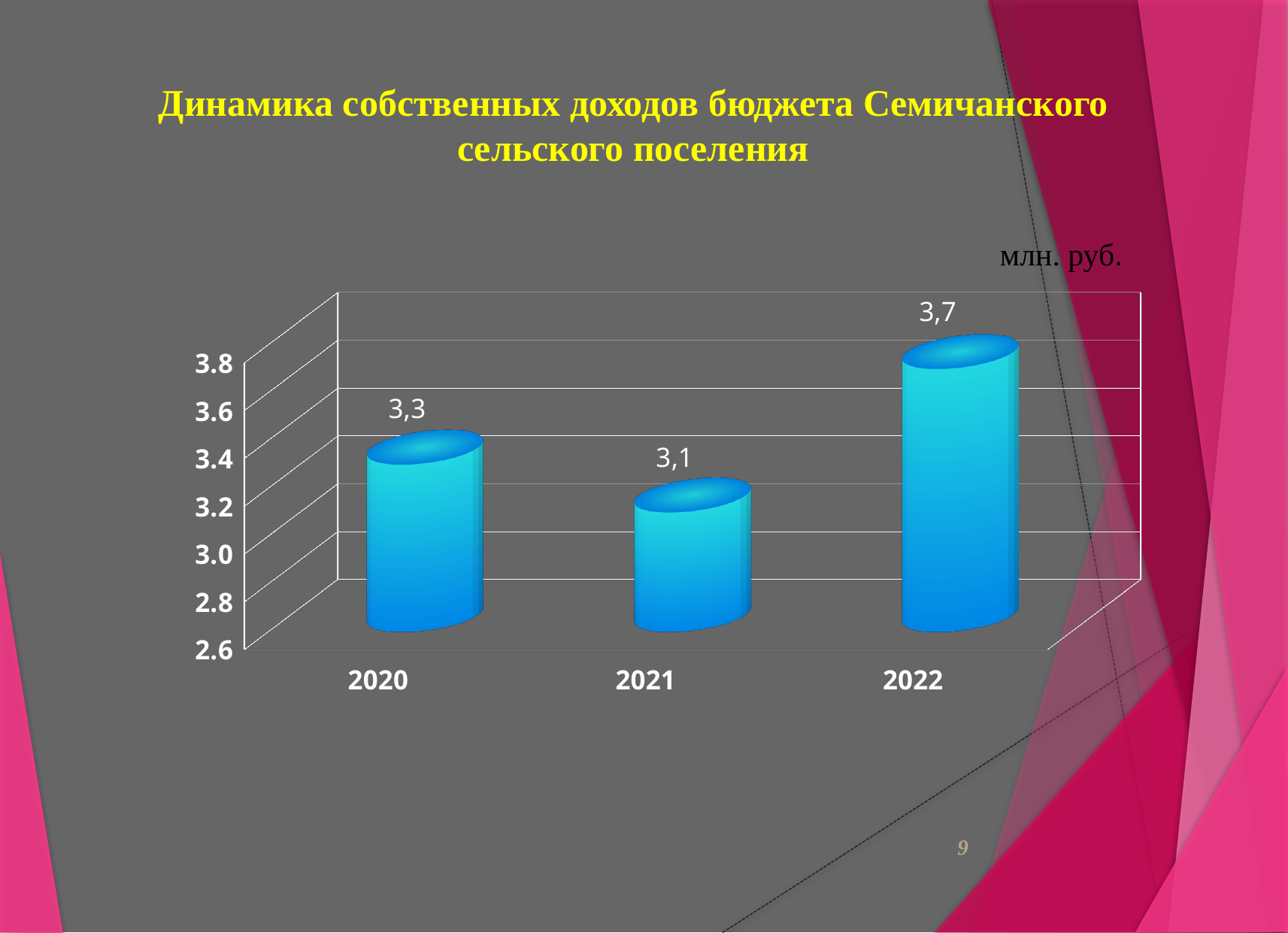
Which is larger, the value for 2020 or the value for 2022? 2022 What is the value for 2021? 3,1 How many years are shown on the chart? 3 What unit is indicated above the chart? млн. руб. What kind of chart is shown on the slide? bar chart What is the value for 2020? 3,3 Which year has the lowest value? 2021 What is the difference between the values for 2022 and 2021? 0,6 Which year has the highest value? 2022 Is the value for 2021 greater or less than 3.2? less What is the value for 2022? 3,7 What is the difference between the values for 2020 and 2021? 0,2